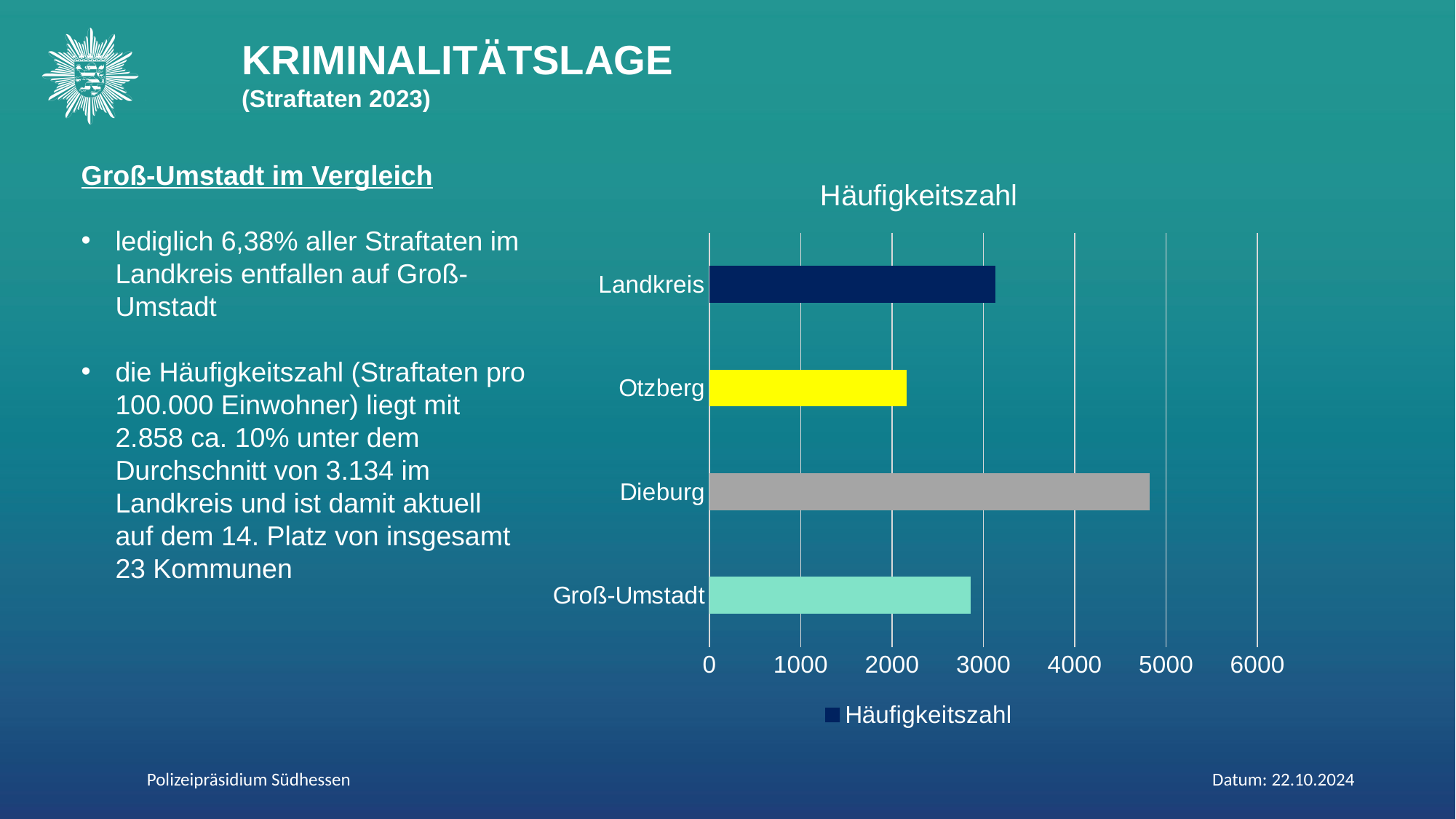
How many series does the legend list? 1 Is the value for Groß-Umstadt greater or less than 3000? less Is the value for Otzberg greater or less than 3000? less Is the value for Landkreis greater or less than 3000? greater What is the title of the chart? Häufigkeitszahl Which category has the highest Häufigkeitszahl? Dieburg What kind of chart is shown on the slide? bar chart Which is larger, the value for Groß-Umstadt or the value for Otzberg? Groß-Umstadt How many categories are plotted in the chart? 4 Which category has the lowest Häufigkeitszahl? Otzberg What colour is the bar for Otzberg? yellow